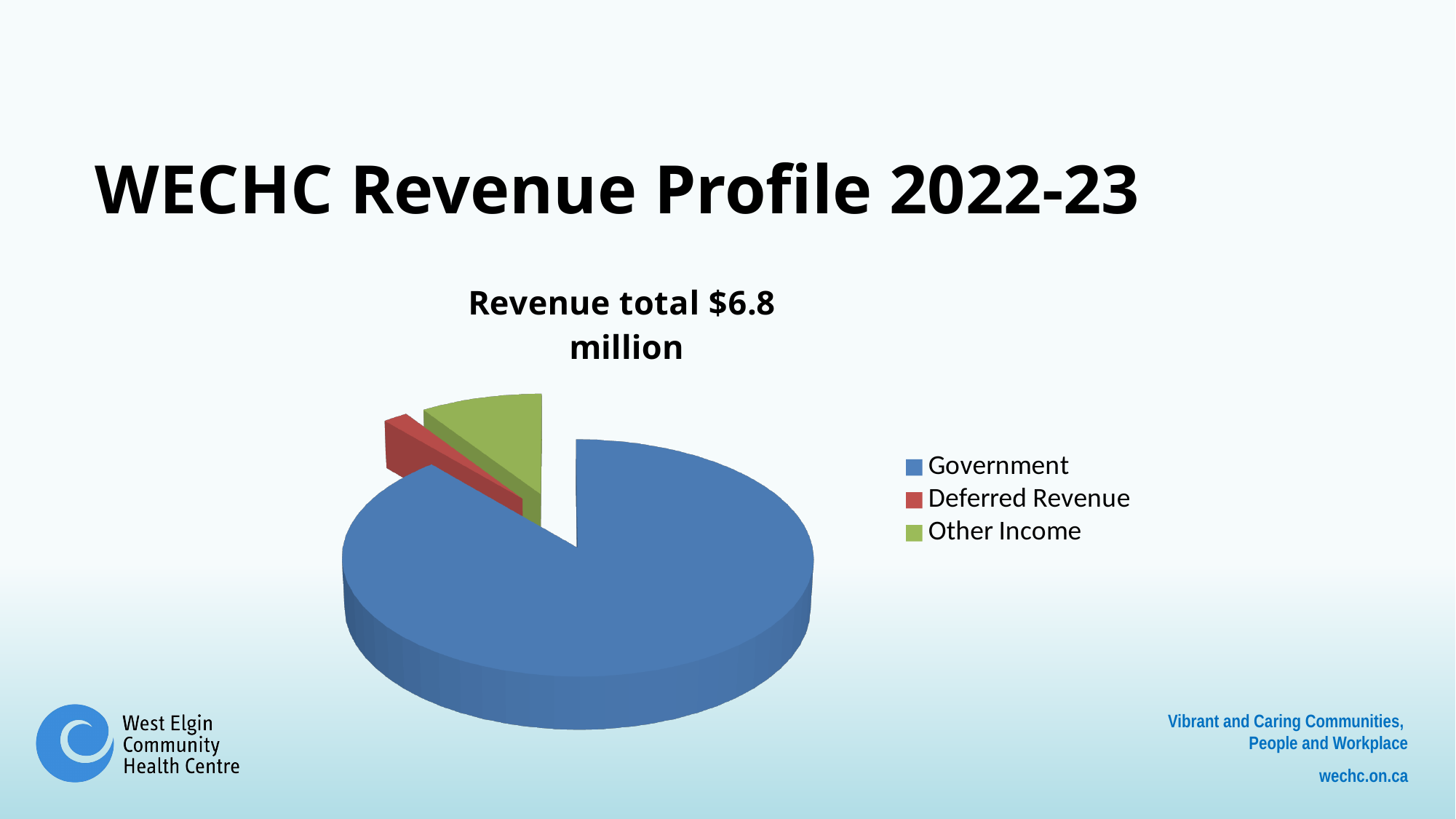
Which colour represents Deferred Revenue in the pie chart? red Which slice is larger, Government or Deferred Revenue? Government How many slices does the pie chart have? 3 Which category has the largest slice of the pie chart? Government How many entries does the legend of the pie chart list? 3 What kind of chart is shown on the slide? pie chart Which slice is larger, Government or Other Income? Government What is the title of the pie chart? Revenue total $6.8 million